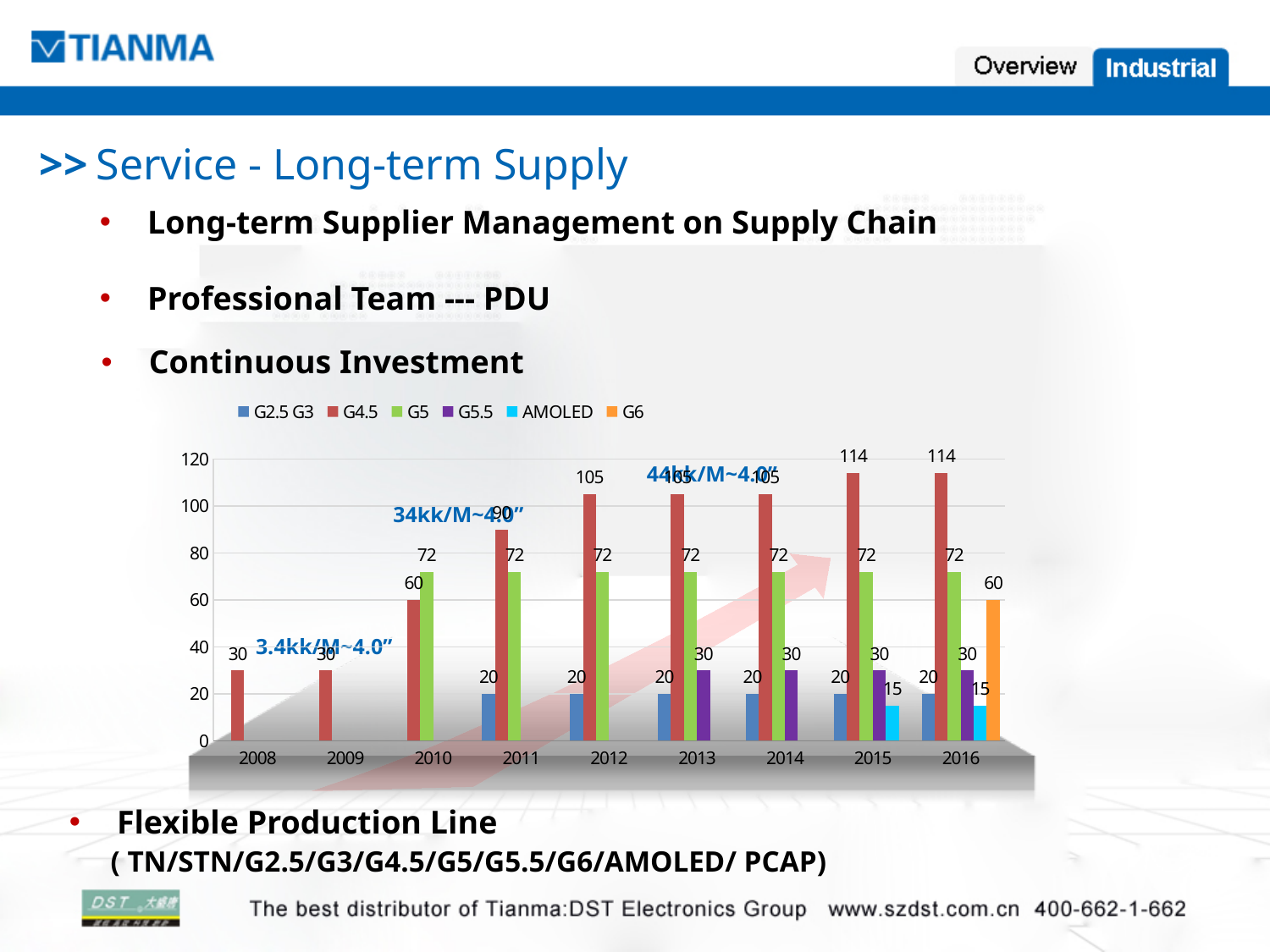
How many years are shown on the x axis? 9 What is the value of the G4.5 series in 2011? 90 What is the value of the G6 series in 2016? 60 Which is larger in 2016, the G5 value or the G6 value? G5 What is the difference between the G4.5 value in 2016 and the G4.5 value in 2008? 84 Which series has the highest value in 2016? G4.5 What kind of chart is shown on the slide? Bar chart What is the value of the G4.5 series in 2016? 114 How many series does the legend list? 6 What is the value of the AMOLED series in 2015? 15 Which series has the lowest value in 2015? AMOLED In which year does the G4.5 series first reach 114? 2015